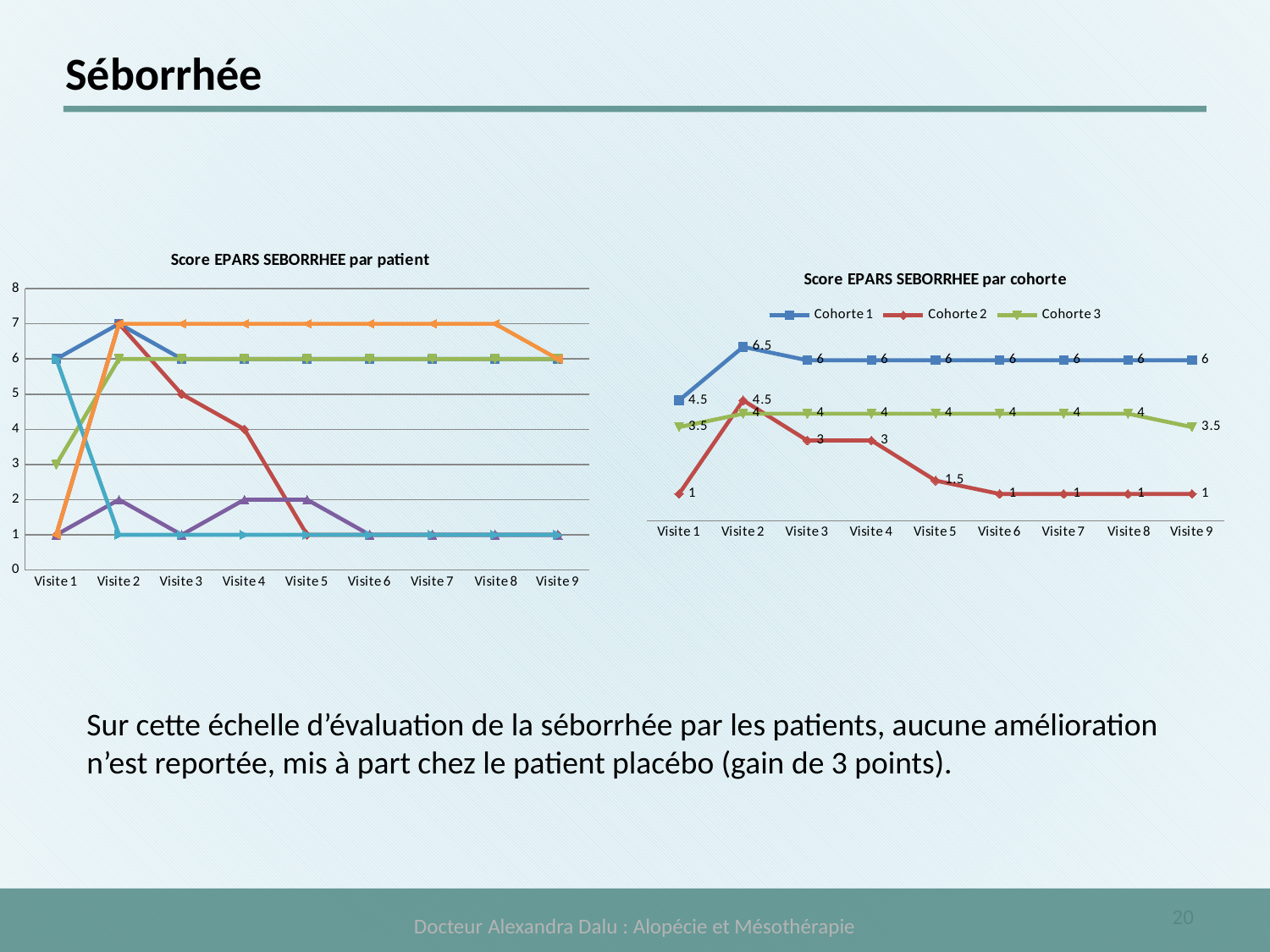
In the chart titled 'Score EPARS SEBORRHEE par cohorte', what is the difference between Cohorte 1 and Cohorte 2 at Visite 9? 5 In the chart titled 'Score EPARS SEBORRHEE par cohorte', what is the value for Cohorte 3 at Visite 9? 3.5 What kind of chart is the chart titled 'Score EPARS SEBORRHEE par cohorte'? Line chart In the chart titled 'Score EPARS SEBORRHEE par cohorte', which is larger at Visite 1: Cohorte 1 or Cohorte 3? Cohorte 1 In the chart titled 'Score EPARS SEBORRHEE par cohorte', at which visit does Cohorte 1 reach its highest value? Visite 2 What is the title of the chart on the left of the slide? Score EPARS SEBORRHEE par patient In the chart titled 'Score EPARS SEBORRHEE par cohorte', at which visit does Cohorte 2 reach its highest value? Visite 2 In the chart titled 'Score EPARS SEBORRHEE par cohorte', what is the value for Cohorte 2 at Visite 5? 1.5 In the chart titled 'Score EPARS SEBORRHEE par cohorte', how many series does the legend list? 3 In the chart titled 'Score EPARS SEBORRHEE par cohorte', what is the value for Cohorte 1 at Visite 2? 6.5 In the chart titled 'Score EPARS SEBORRHEE par cohorte', how many visits are shown on the x axis? 9 In the chart titled 'Score EPARS SEBORRHEE par cohorte', does the value for Cohorte 2 rise or fall from Visite 2 to Visite 6? Fall